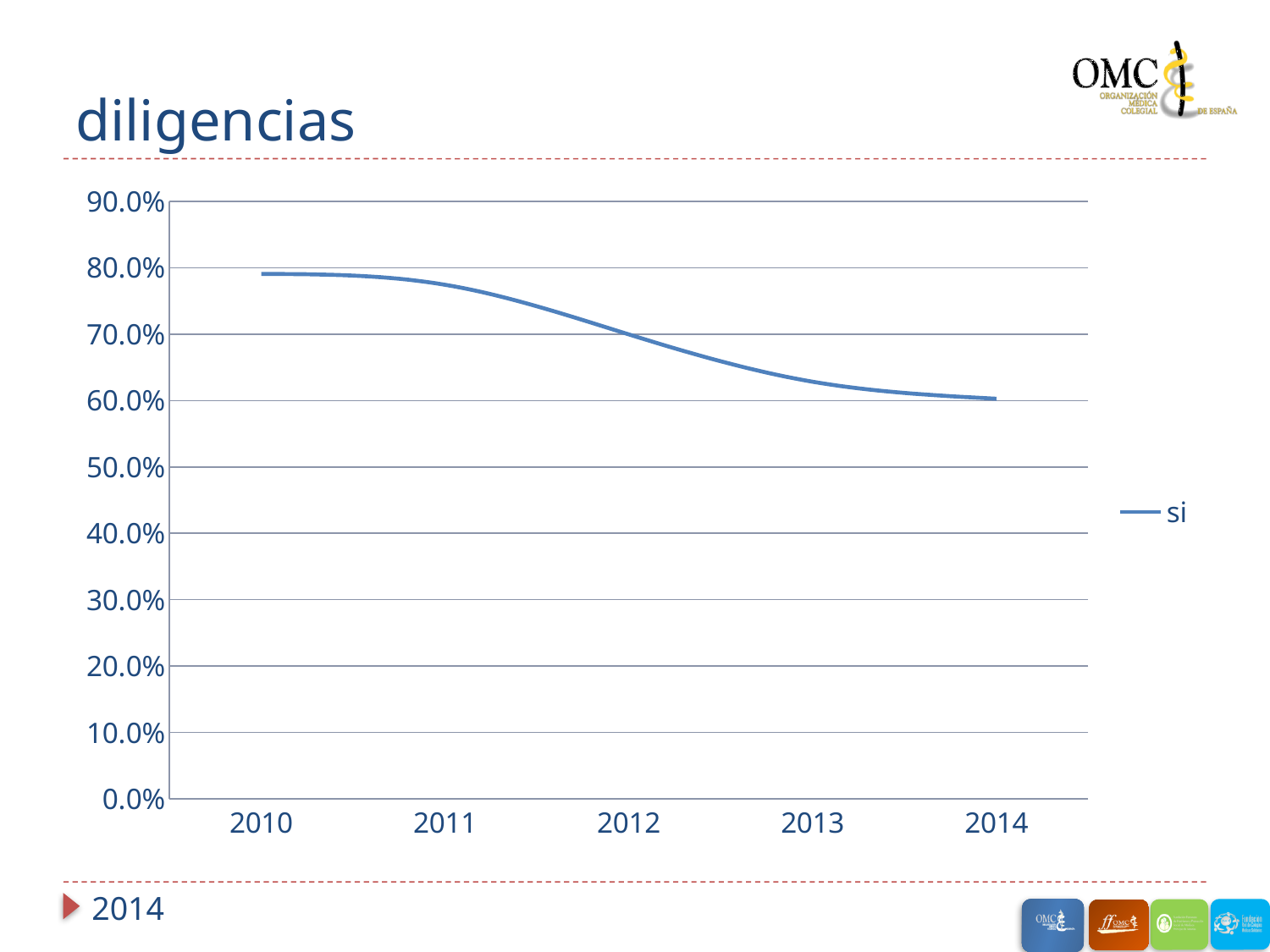
Is the value for 2010 greater or less than 70.0%? greater How many series does the legend list? 1 Is the value for 2013 greater or less than 70.0%? less Which year has the lowest value? 2014 What kind of chart is shown on the slide? line chart Do the values rise or fall from 2010 to 2014? fall What is the name of the series shown in the legend? si Which is larger, the value for 2010 or the value for 2014? 2010 Is the value for 2014 greater or less than 70.0%? less What is the title of the slide containing the chart? diligencias How many years are plotted along the x axis? 5